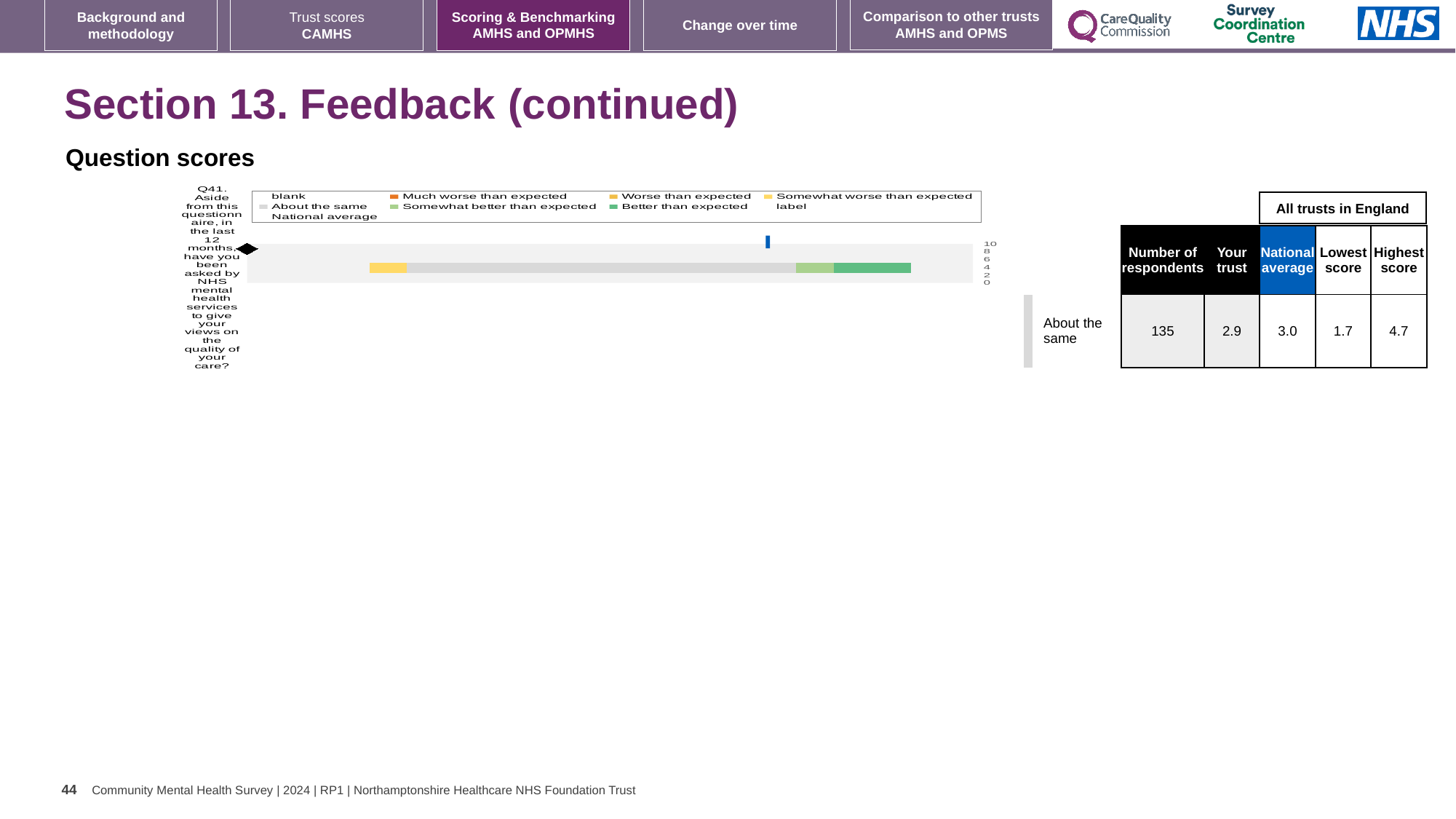
In the table for Q41, what is the score for Your trust? 2.9 How many survey questions are plotted in the chart? 1 What kind of chart is shown for Q41 on the slide? bar chart What benchmark category is shown for Q41 next to the table? About the same In the table for Q41, what is the Lowest score among all trusts in England? 1.7 For Q41, which is larger: the Your trust score or the National average score? National average What is the highest tick value shown on the chart's score axis? 10 In the table for Q41, what is the number of respondents? 135 How many entries does the chart legend list? 9 In the table for Q41, what is the Highest score among all trusts in England? 4.7 In the table for Q41, what is the National average score? 3.0 Which question number is plotted in the chart? Q41